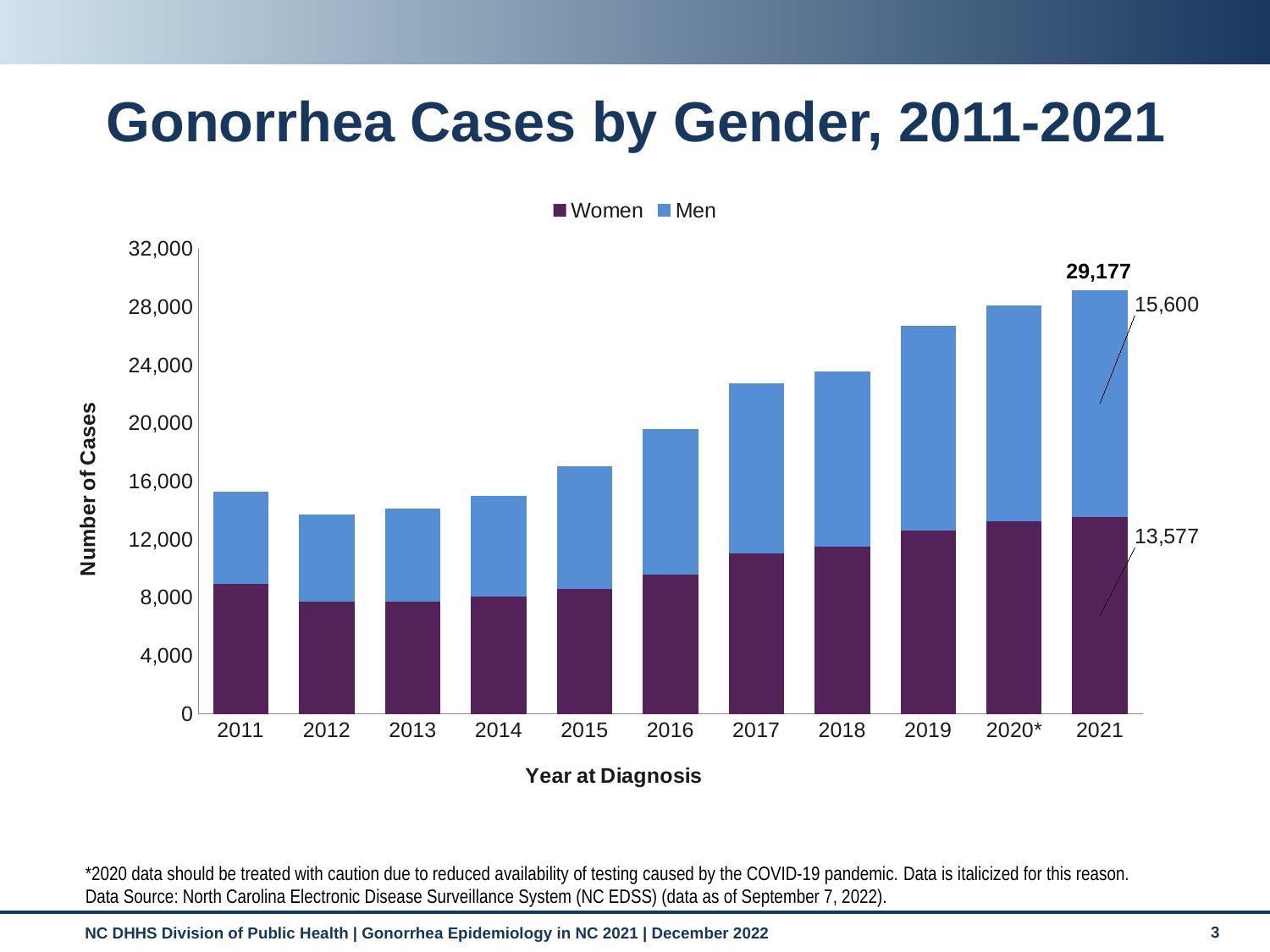
What kind of chart is shown on the slide? Stacked bar chart How many gonorrhea cases among men are shown for 2021? 15,600 In 2021, which group had more cases, women or men? Men What is the title of the x axis? Year at Diagnosis Is the total number of cases for 2017 greater or less than 20,000? greater How many gonorrhea cases among women are shown for 2021? 13,577 How many series does the legend list? 2 How many years are shown on the x axis? 11 Which year has the highest total number of cases? 2021 What is the total number of gonorrhea cases shown for 2021? 29,177 Is the total number of cases for 2011 greater or less than 16,000? less In 2021, how many more cases were there among men than among women? 2,023